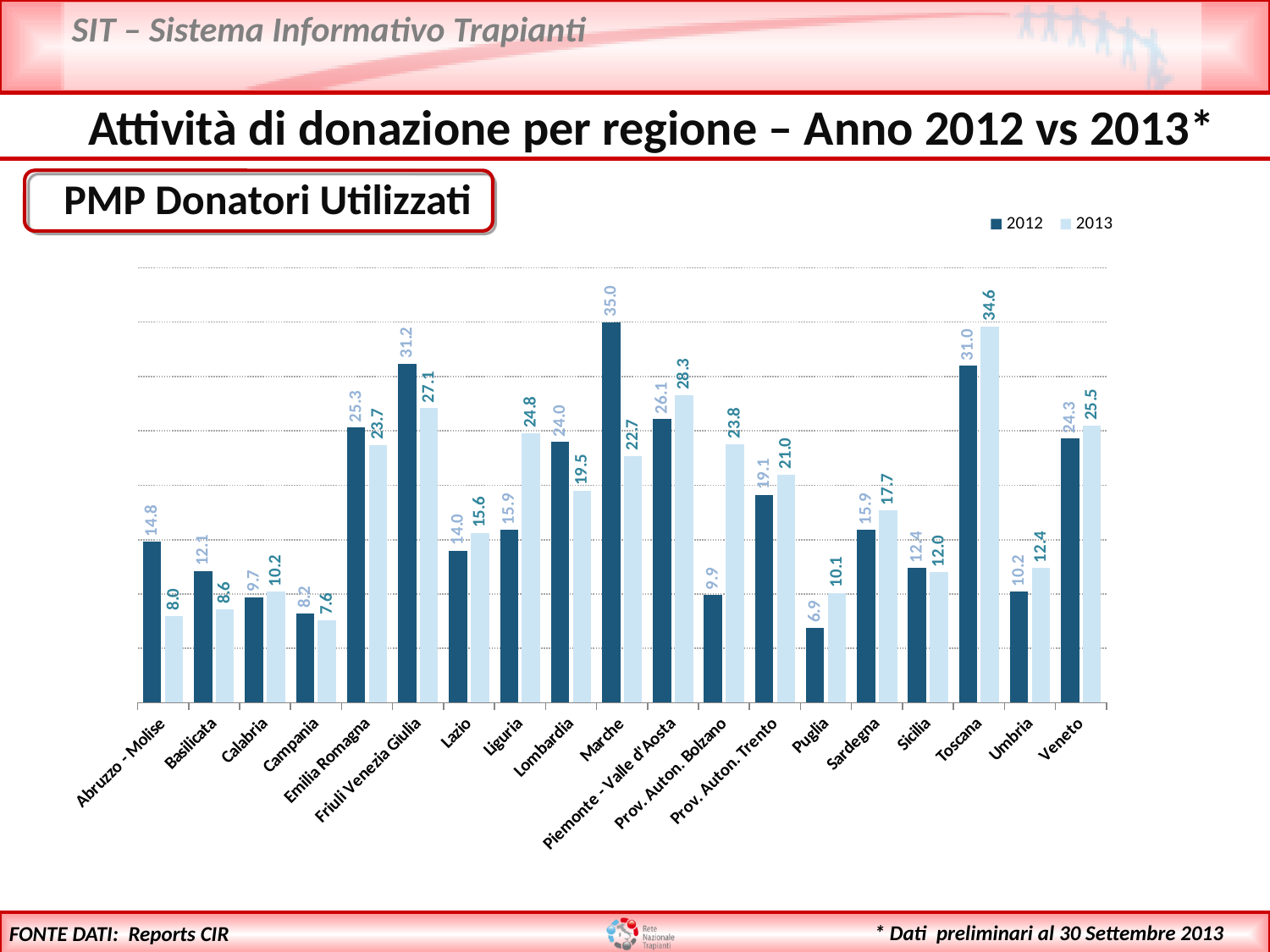
Which region has the highest 2013 value? Toscana What is the 2013 value for Liguria? 24.8 Which is larger for Friuli Venezia Giulia, the 2012 value or the 2013 value? 2012 Which region has the lowest 2013 value? Campania Which region has the lowest 2012 value? Puglia What kind of chart is shown on the slide? Bar chart Which region has the highest 2012 value? Marche How many regions are shown on the x axis? 19 What is the 2012 value for Marche? 35.0 How many series does the legend list? 2 What is the difference between the 2012 and 2013 values for Marche? 12.3 What is the 2013 value for Prov. Auton. Bolzano? 23.8